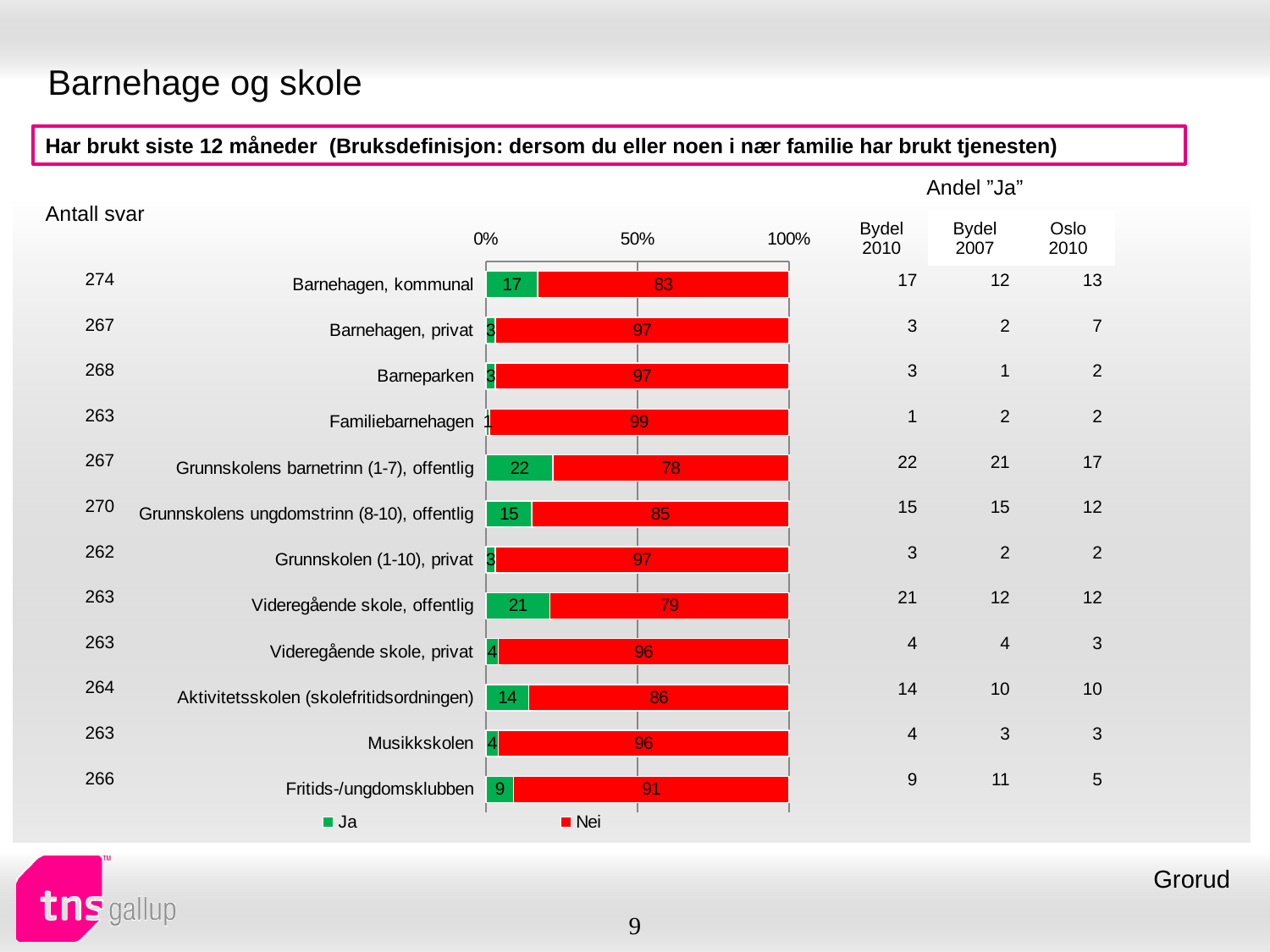
What is the "Ja" value for Aktivitetsskolen (skolefritidsordningen)? 14 Which has a larger "Ja" value: Videregående skole, offentlig or Aktivitetsskolen (skolefritidsordningen)? Videregående skole, offentlig What kind of chart is shown on the slide? Stacked bar chart What is the total of the stacked bar for Barnehagen, kommunal? 100 Which category has the highest "Ja" value? Grunnskolens barnetrinn (1-7), offentlig What is the "Ja" value for Barnehagen, kommunal? 17 How many series does the chart legend list? 2 What are the two legend entries of the chart? Ja and Nei What is the difference between the "Ja" values for Grunnskolens barnetrinn (1-7), offentlig and Grunnskolens ungdomstrinn (8-10), offentlig? 7 What is the "Nei" value for Fritids-/ungdomsklubben? 91 How many categories are plotted in the chart? 12 Which category has the lowest "Ja" value? Familiebarnehagen